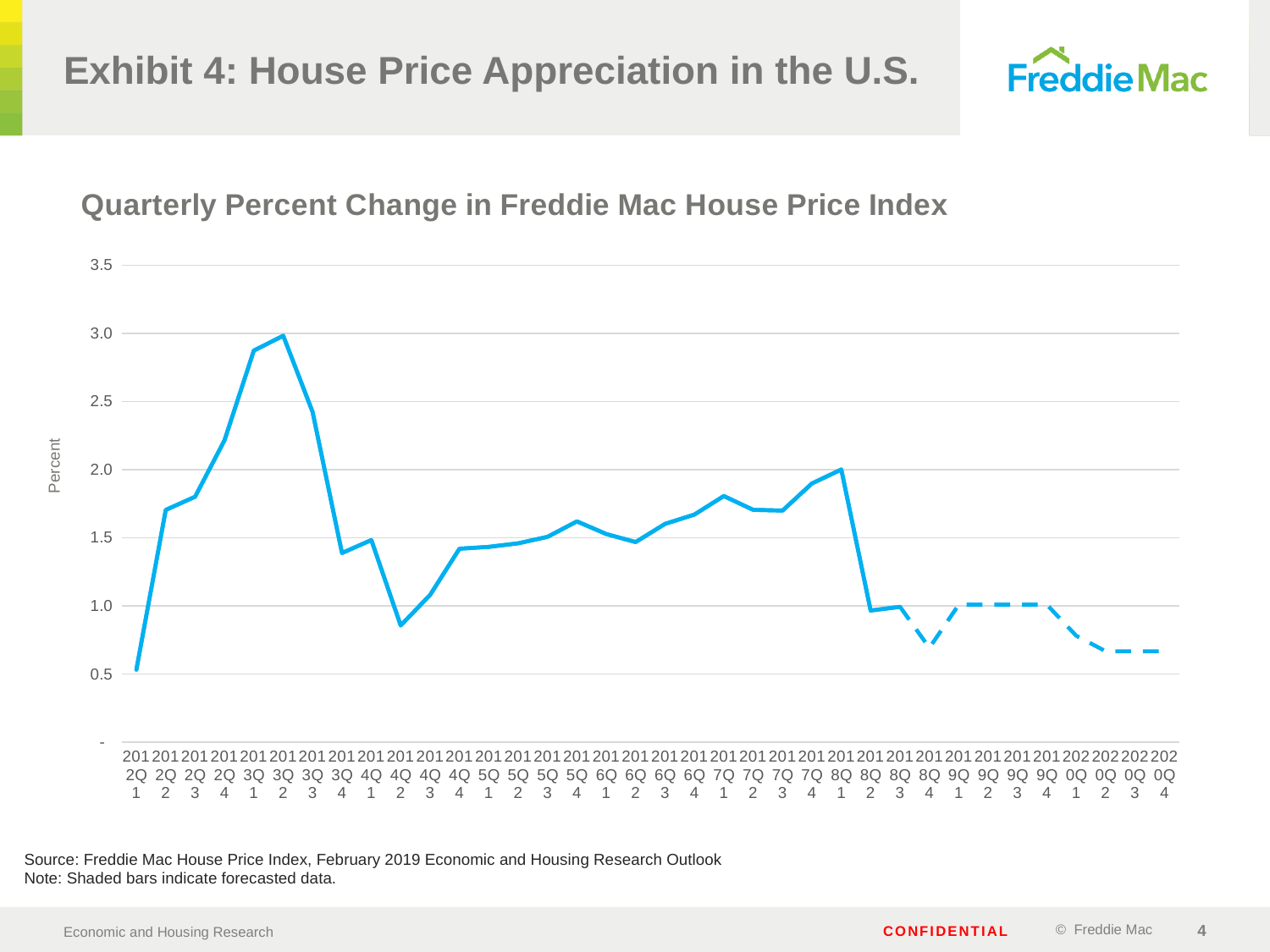
Is the highest value on the line greater or less than 2.5? greater Is the value for the last quarter plotted (2020 Q4) greater or less than 1.0? less Is the value for 2018 Q1 greater or less than 1.5? greater How many quarterly data points are plotted on the chart? 36 What kind of chart is shown on the slide? Line chart Which is larger, the value for 2013 Q2 or the value for 2018 Q1? 2013 Q2 Does the line rise or fall between 2012 Q1 and 2013 Q2? rises What is the label on the vertical axis of the chart? Percent What is the title of the chart? Quarterly Percent Change in Freddie Mac House Price Index Does the line rise or fall between 2018 Q1 and 2018 Q2? falls